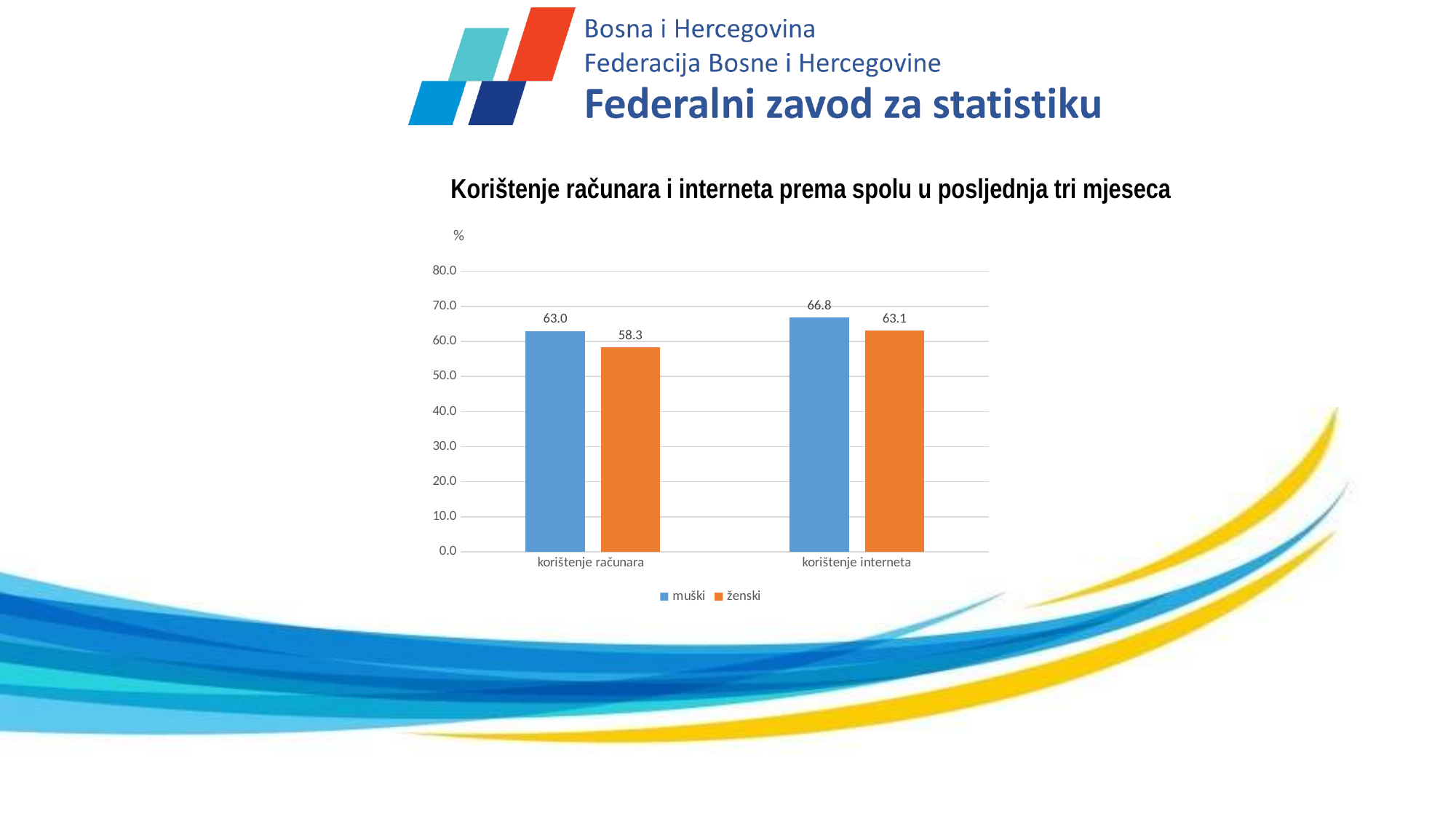
How many categories are shown on the x axis? 2 Which is larger: the ženski value for korištenje interneta or the muški value for korištenje računara? ženski value for korištenje interneta What is the value for muški in the korištenje računara category? 63.0 What kind of chart is shown on the slide? bar chart What is the value for ženski in the korištenje interneta category? 63.1 Which series has the highest value in the korištenje interneta category? muški Which bar has the lowest value on the chart? ženski, korištenje računara What is the value for ženski in the korištenje računara category? 58.3 What is the value for muški in the korištenje interneta category? 66.8 What is the difference between the muški values for korištenje interneta and korištenje računara? 3.8 How many series does the legend list? 2 What is the difference between the muški and ženski values for korištenje računara? 4.7